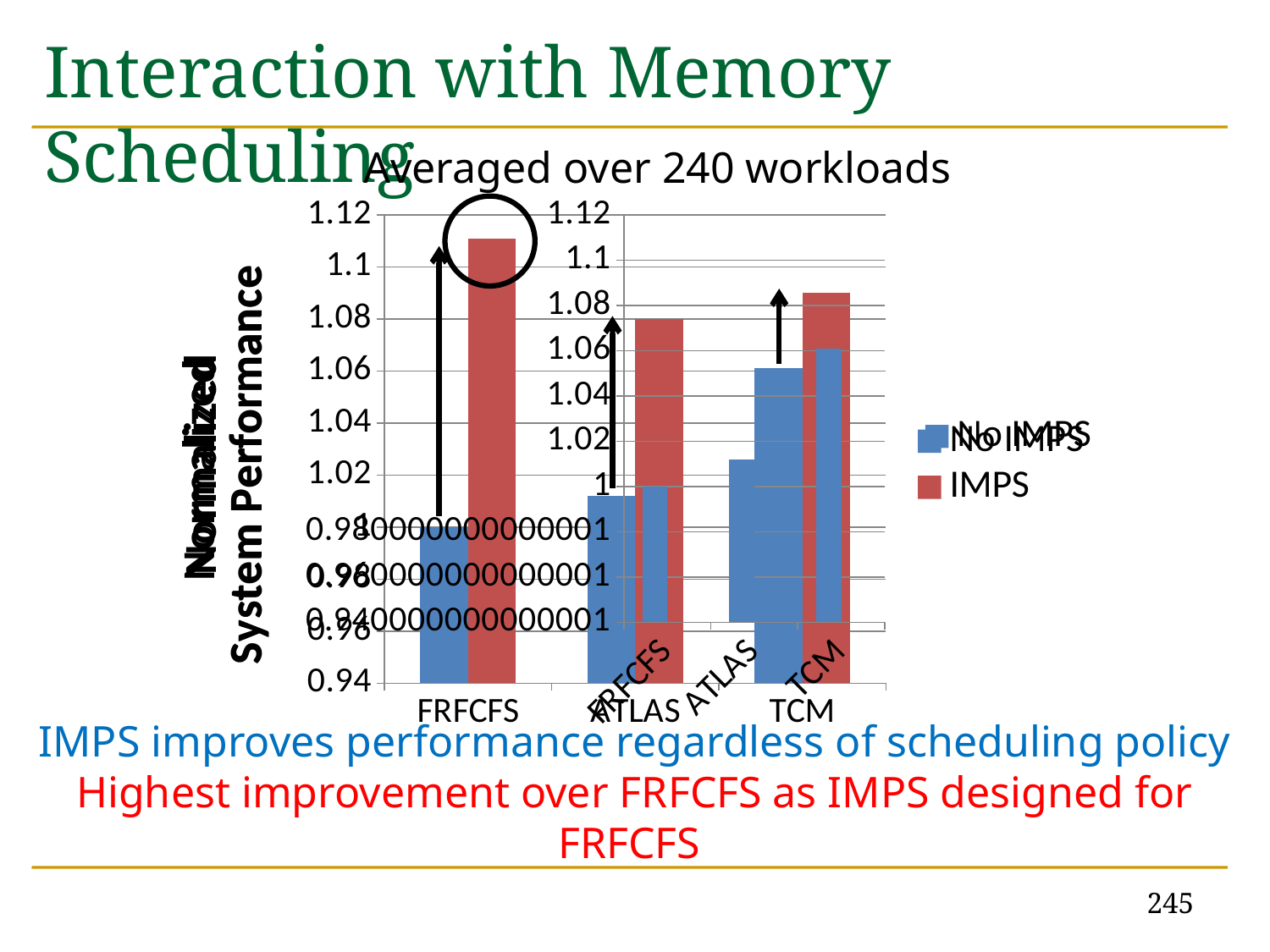
In the front chart, which scheduling policy has the highest IMPS bar? FRFCFS How many series does the chart legend list? 2 What is the title shown above the chart? Averaged over 240 workloads In the front chart, for TCM, which is larger: the No IMPS bar or the IMPS bar? IMPS In the front chart, is the No IMPS value for FRFCFS greater or less than 1.04? less What are the two series named in the chart legend? No IMPS and IMPS In the front chart, is the IMPS value for FRFCFS greater or less than 1.1? greater In the front chart, is the IMPS value for ATLAS greater or less than 1.1? less In the front chart, which scheduling policy has the lowest No IMPS bar? FRFCFS What kind of chart is shown on the slide? Bar chart In the front chart, for FRFCFS, which is larger: the No IMPS bar or the IMPS bar? IMPS How many scheduling policies (categories) are shown on the x axis of the chart? 3